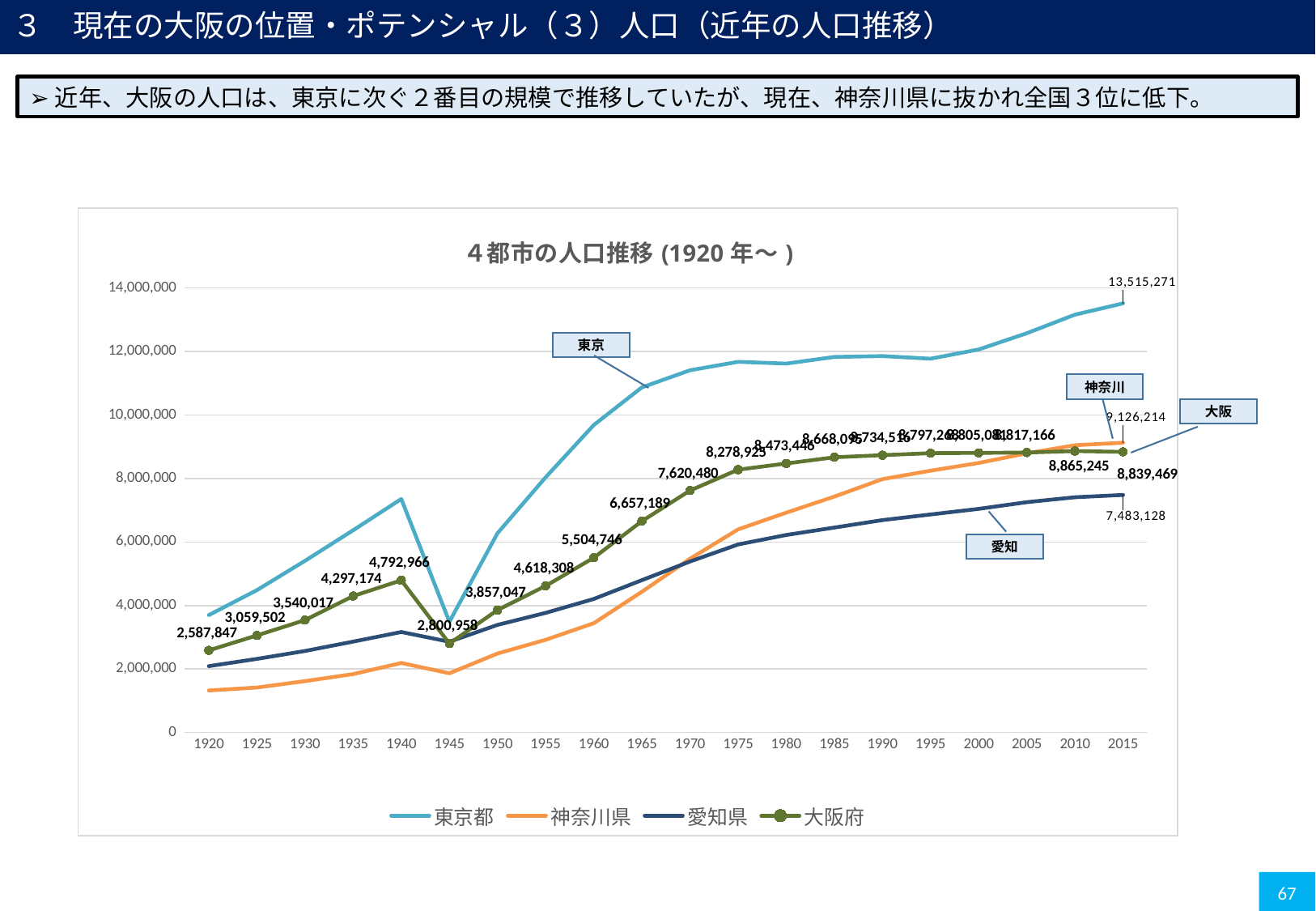
What is the population of 大阪府 in 1945 according to the chart? 2,800,958 What is the population of 愛知県 in 2015 according to the chart? 7,483,128 What is the population of 神奈川県 in 2015 according to the chart? 9,126,214 What kind of chart is shown on the slide? line chart What is the population of 大阪府 in 1920 according to the chart? 2,587,847 Which series has the highest value in 2015? 東京都 How many series does the chart legend list? 4 Which series has the lowest value in 1920? 神奈川県 What is the difference between the 2015 populations of 神奈川県 and 大阪府? 286,745 What is the population of 東京都 in 2015 according to the chart? 13,515,271 What is the population of 大阪府 in 1940 according to the chart? 4,792,966 Is the value for 東京都 in 1965 greater or less than 10,000,000? greater